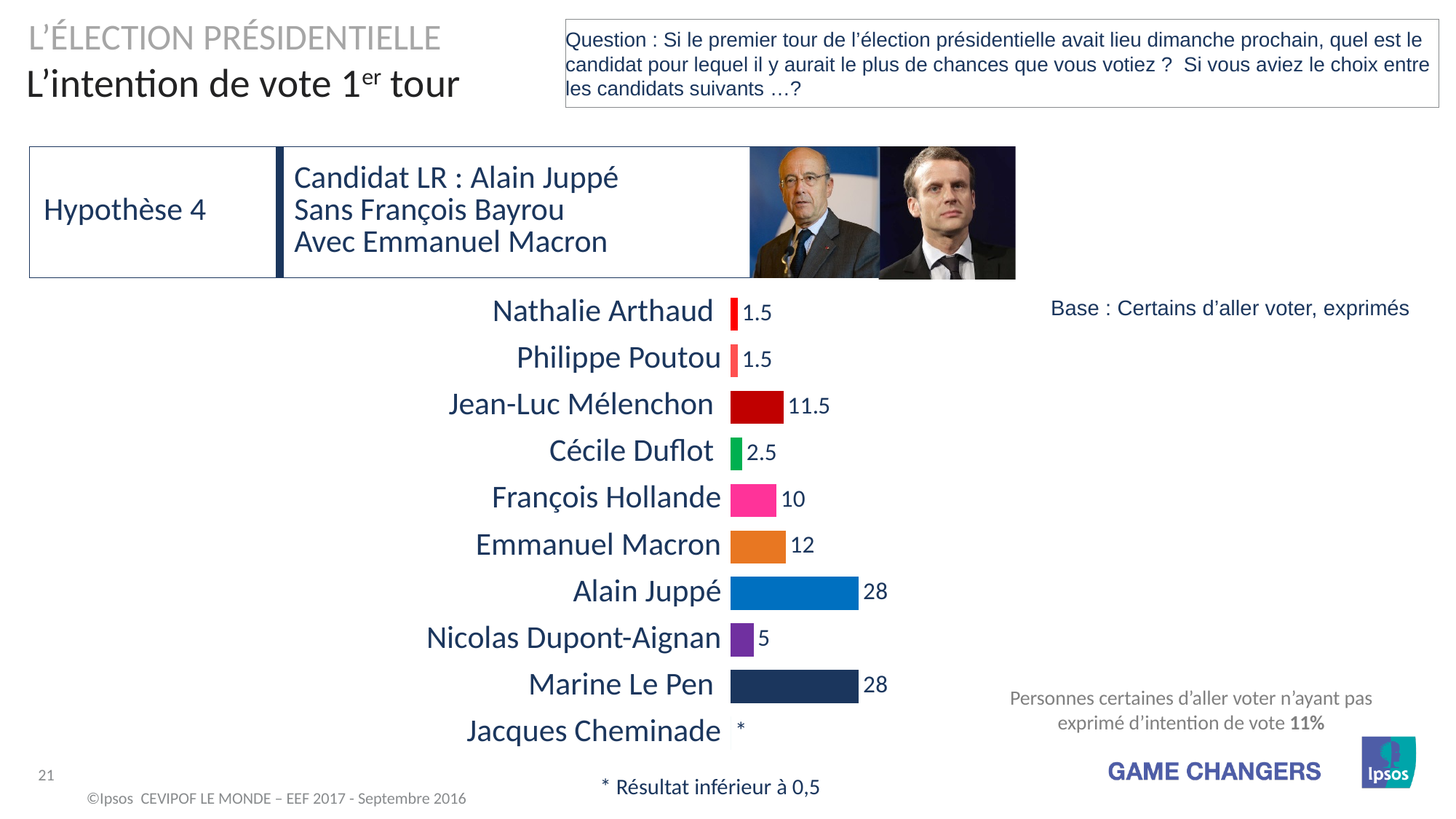
What is the vote intention value shown for Alain Juppé? 28 What is the value shown for Emmanuel Macron? 12 Which candidate has the lowest vote intention on the chart? Jacques Cheminade Who has the larger value, Emmanuel Macron or François Hollande? Emmanuel Macron What is the value shown for Nicolas Dupont-Aignan? 5 What is the highest value shown on the chart? 28 What kind of chart is shown on the slide? Bar chart What is the difference between the values for Alain Juppé and Emmanuel Macron? 16 How many candidates are listed on the chart? 10 What is the difference between the values for Jean-Luc Mélenchon and François Hollande? 1.5 According to the footnote, what does the asterisk next to Jacques Cheminade mean? Résultat inférieur à 0,5 What is the value shown for Jean-Luc Mélenchon? 11.5